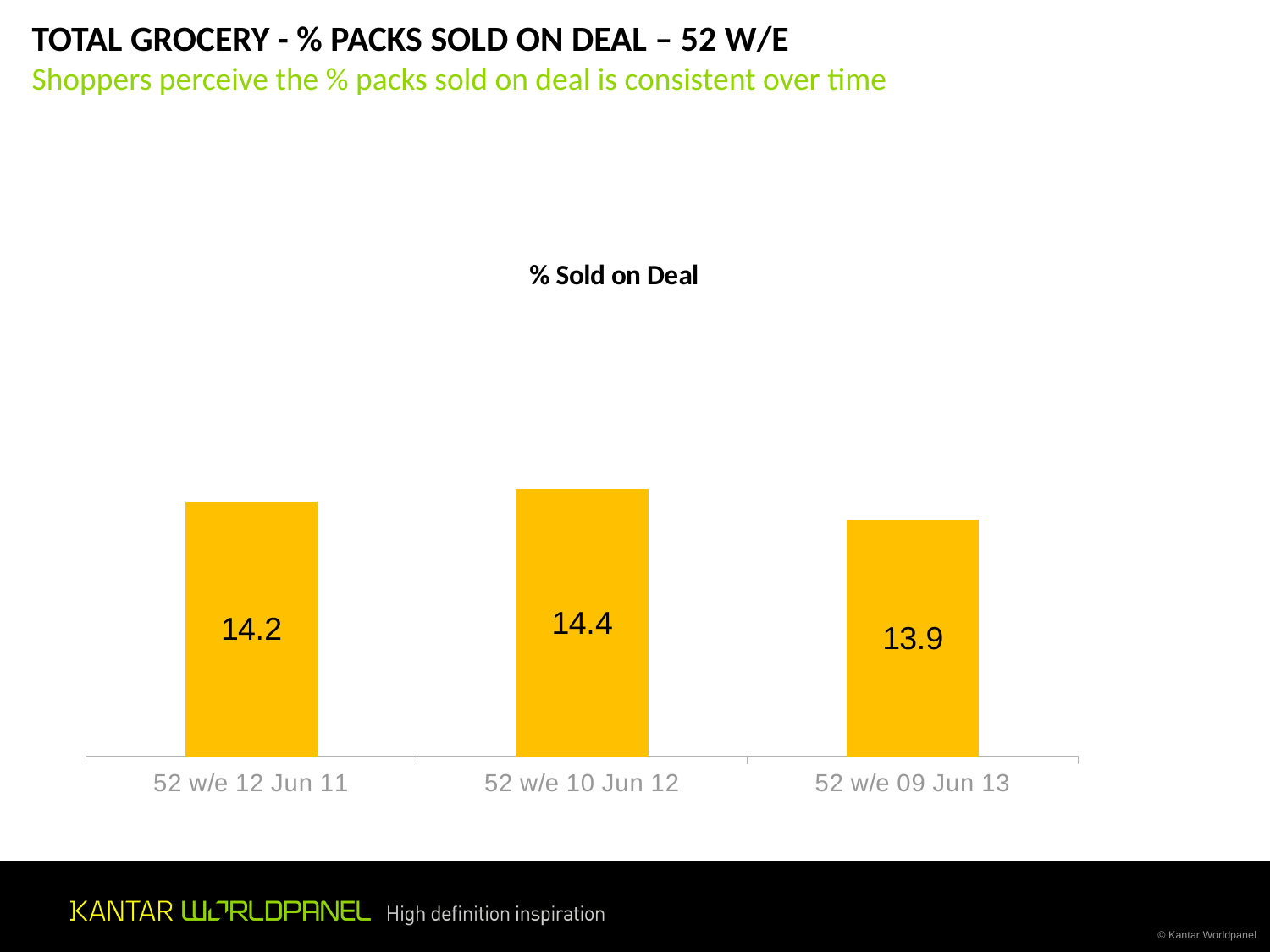
What is the % Sold on Deal value for 52 w/e 09 Jun 13? 13.9 Does the % Sold on Deal rise or fall from 52 w/e 10 Jun 12 to 52 w/e 09 Jun 13? Fall Which period has the highest % Sold on Deal? 52 w/e 10 Jun 12 What is the title of the chart? % Sold on Deal How many periods are shown in the chart? 3 What is the difference in % Sold on Deal between 52 w/e 10 Jun 12 and 52 w/e 09 Jun 13? 0.5 Which is larger, the % Sold on Deal for 52 w/e 12 Jun 11 or for 52 w/e 10 Jun 12? 52 w/e 10 Jun 12 What type of chart is shown on the slide? Bar chart What is the difference in % Sold on Deal between 52 w/e 12 Jun 11 and 52 w/e 09 Jun 13? 0.3 What is the % Sold on Deal value for 52 w/e 10 Jun 12? 14.4 Which period has the lowest % Sold on Deal? 52 w/e 09 Jun 13 What is the % Sold on Deal value for 52 w/e 12 Jun 11? 14.2